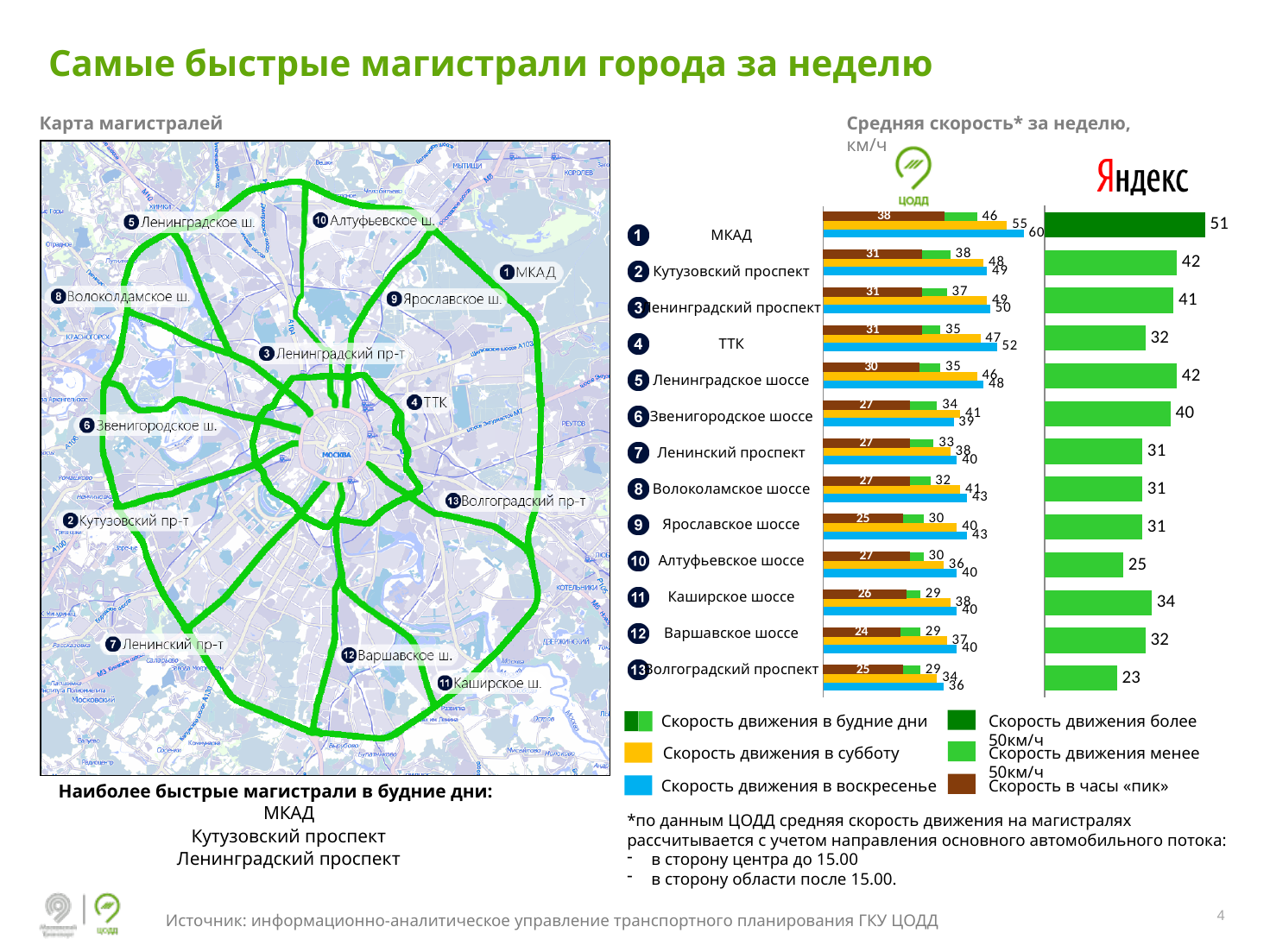
On the ЦОДД chart, what is the Sunday speed (Скорость движения в воскресенье) for МКАД? 60 On the ЦОДД chart, what is the difference between the Sunday speed and the peak-hour speed for МКАД? 22 On the Яндекс chart, what is the difference between the values for Кутузовский проспект and Алтуфьевское шоссе? 17 On the Яндекс chart, which road is shown in dark green as having a speed above 50 km/h? МКАД On the ЦОДД chart, what is the peak-hour speed (Скорость в часы «пик») for Варшавское шоссе? 24 On the Яндекс chart, which road has the highest average weekly speed? МКАД On the Яндекс chart, which road has the lowest average weekly speed? Волгоградский проспект On the ЦОДД chart, what is the Saturday speed (Скорость движения в субботу) for ТТК? 47 On the ЦОДД chart, which is larger for Звенигородское шоссе: the Saturday speed or the Sunday speed? Saturday speed (41) On the Яндекс chart, what is the average weekly speed for МКАД? 51 What type of chart is the Яндекс chart? Bar chart How many roads are listed on the ЦОДД chart? 13